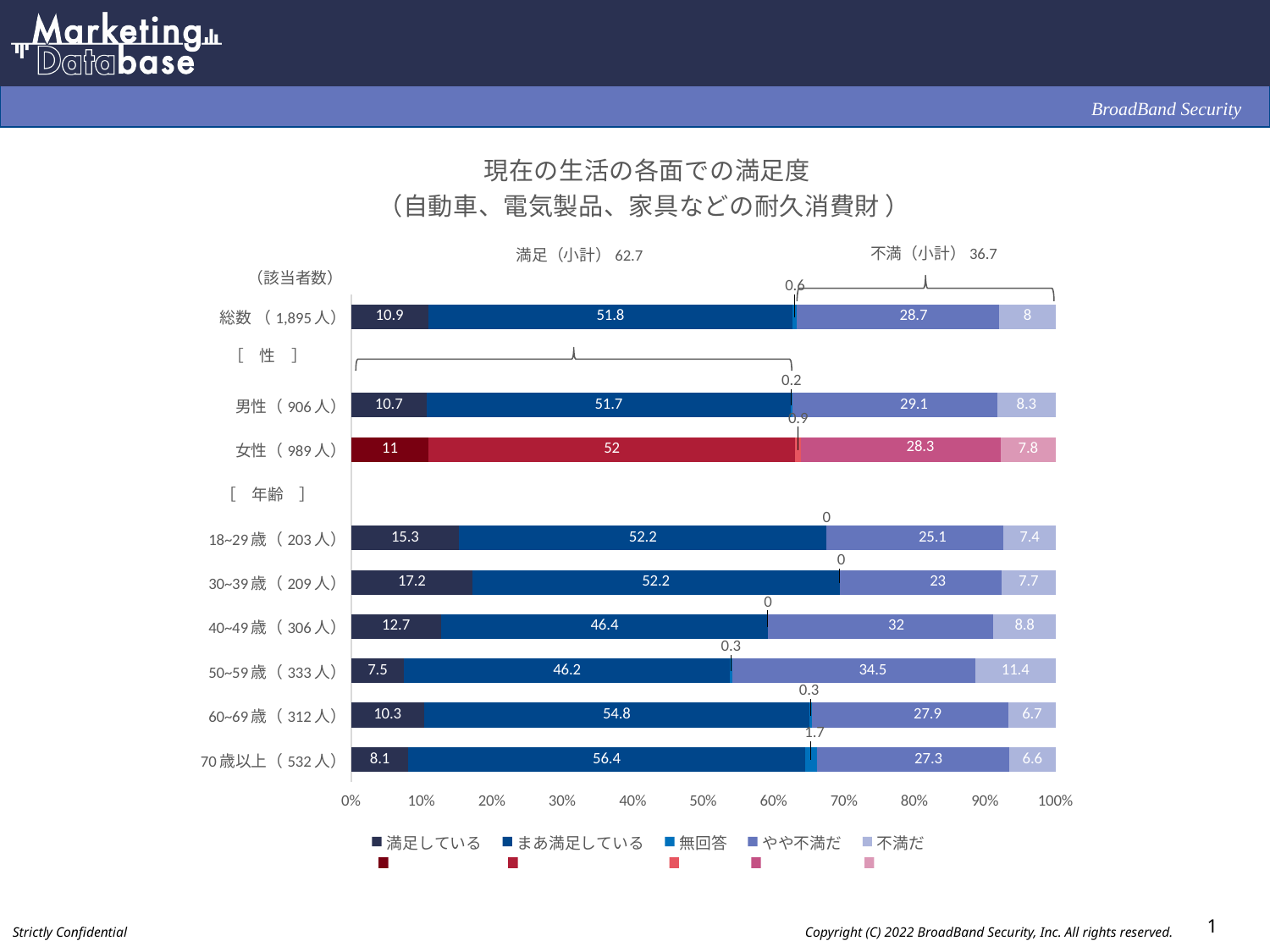
How many series does the legend list? 5 What kind of chart is shown on the slide? Stacked bar chart What is the value of 不満だ for 50~59歳? 11.4 What is the value of 無回答 for 女性? 0.9 What is the total of the stacked bar for 総数? 100 What is the value of まあ満足している for 70歳以上? 56.4 Which category has the lowest value for 満足している? 50~59歳 What is the 満足（小計） value shown above the chart? 62.7 Which is larger, the まあ満足している value for 60~69歳 or for 40~49歳? 60~69歳 Which category has the highest value for 満足している? 30~39歳 How many categories (bars) are plotted in the chart? 9 What is the difference between the やや不満だ values for 50~59歳 and 30~39歳? 11.5